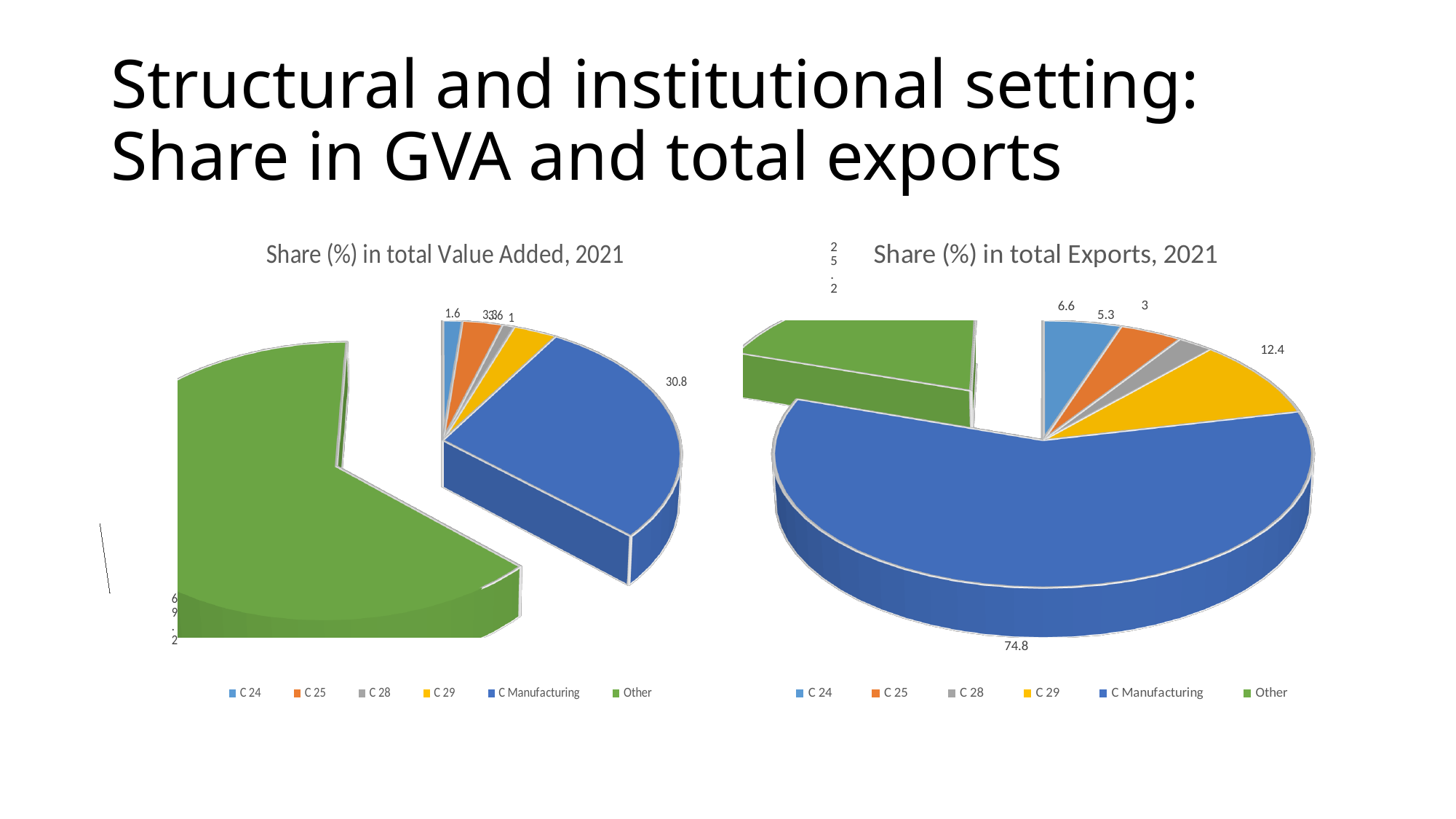
In the chart titled "Share (%) in total Exports, 2021", which is larger, the value for C 24 or the value for C 25? C 24 In the chart titled "Share (%) in total Exports, 2021", what is the value for C 24? 6.6 In the chart titled "Share (%) in total Exports, 2021", what is the value for C 29? 12.4 In the chart titled "Share (%) in total Exports, 2021", which category has the largest slice? C Manufacturing In the chart titled "Share (%) in total Value Added, 2021", what is the value for C 24? 1.6 In the chart titled "Share (%) in total Exports, 2021", what is the value for C Manufacturing? 74.8 In the chart titled "Share (%) in total Exports, 2021", what is the value for C 25? 5.3 In the chart titled "Share (%) in total Exports, 2021", which category has the smallest slice? C 28 In the chart titled "Share (%) in total Value Added, 2021", what is the value for C Manufacturing? 30.8 In the chart titled "Share (%) in total Value Added, 2021", which category has the largest slice? Other How many entries does the legend of the chart titled "Share (%) in total Value Added, 2021" list? 6 In the chart titled "Share (%) in total Exports, 2021", what is the difference between the values for C Manufacturing and C 29? 62.4